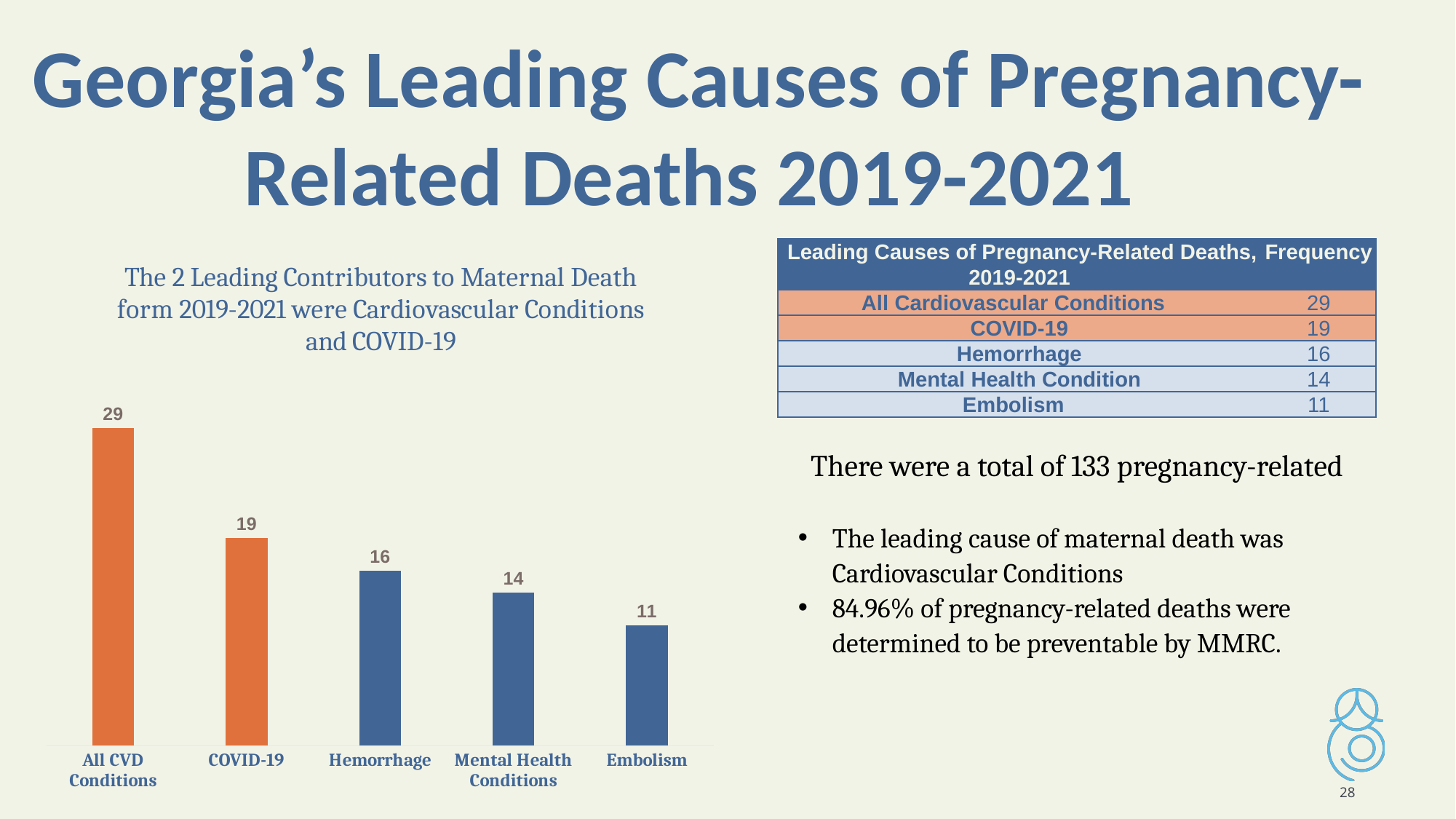
What is the difference between the values for All CVD Conditions and COVID-19 in the bar chart? 10 What kind of chart is shown on the slide? Bar chart Do the values in the bar chart rise or fall from left to right? Fall What is the value for COVID-19 in the bar chart? 19 What is the value for Hemorrhage in the bar chart? 16 Which category has the lowest value in the bar chart? Embolism Which category has the highest value in the bar chart? All CVD Conditions What is the value for Embolism in the bar chart? 11 How many categories are shown in the bar chart? 5 Which is larger in the bar chart, Mental Health Conditions or Hemorrhage? Hemorrhage What is the difference between the values for Hemorrhage and Embolism in the bar chart? 5 What is the value for All CVD Conditions in the bar chart? 29